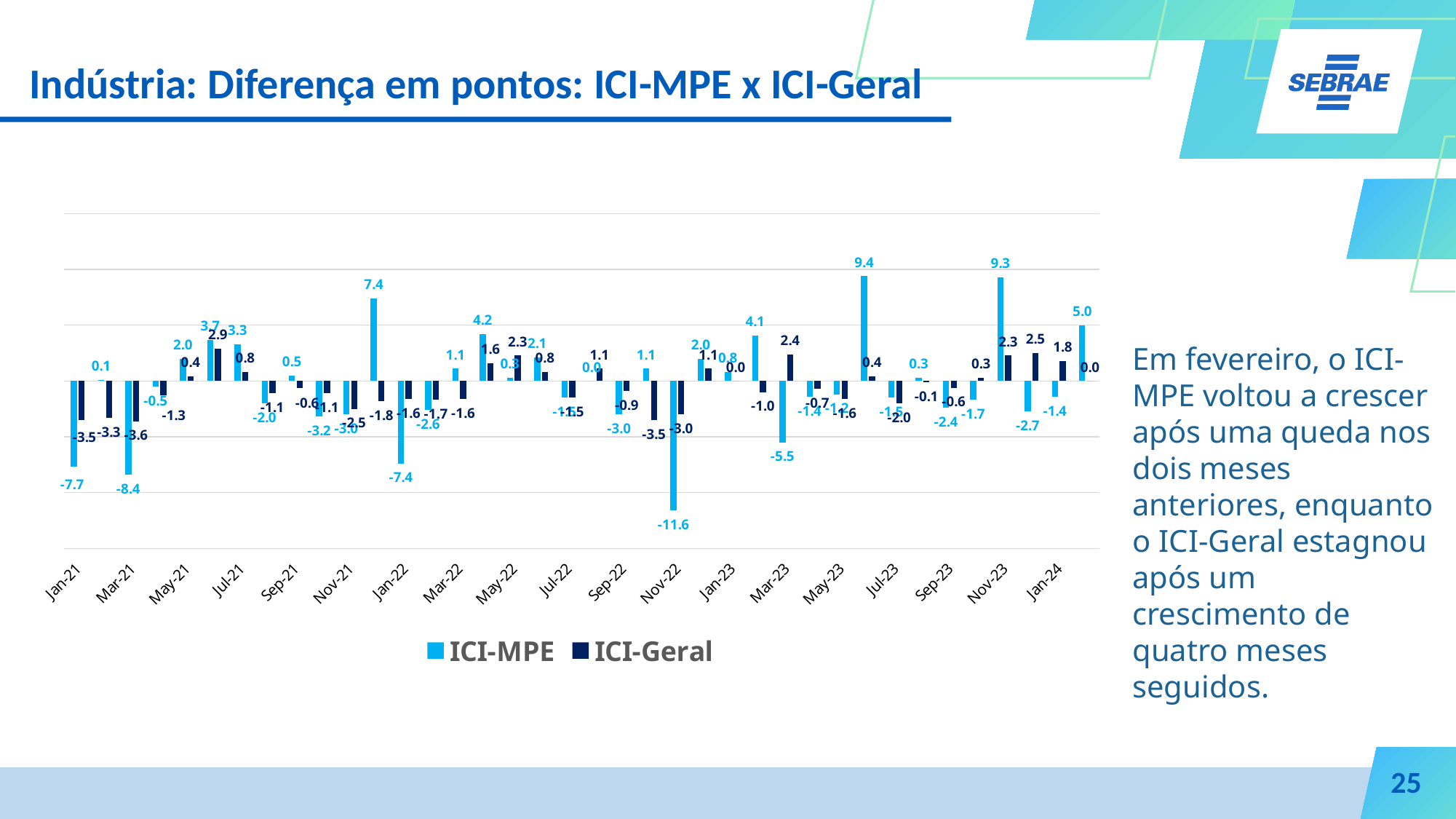
What is the lowest ICI-MPE value shown in the chart? -11.6 What is the ICI-MPE value for Nov-22? -11.6 What is the highest ICI-MPE value shown in the chart? 9.4 What is the ICI-Geral value for Nov-22? -3.0 What are the two series named in the chart legend? ICI-MPE and ICI-Geral What is the difference between the ICI-MPE and ICI-Geral values for Nov-22? 8.6 What kind of chart is shown on the slide? Bar chart Which series has the larger value for Jan-24, ICI-MPE or ICI-Geral? ICI-Geral How many series does the chart legend list? 2 What is the ICI-MPE value for Jan-21? -7.7 How many month labels are shown on the x axis? 19 What is the ICI-Geral value for Jan-24? 1.8